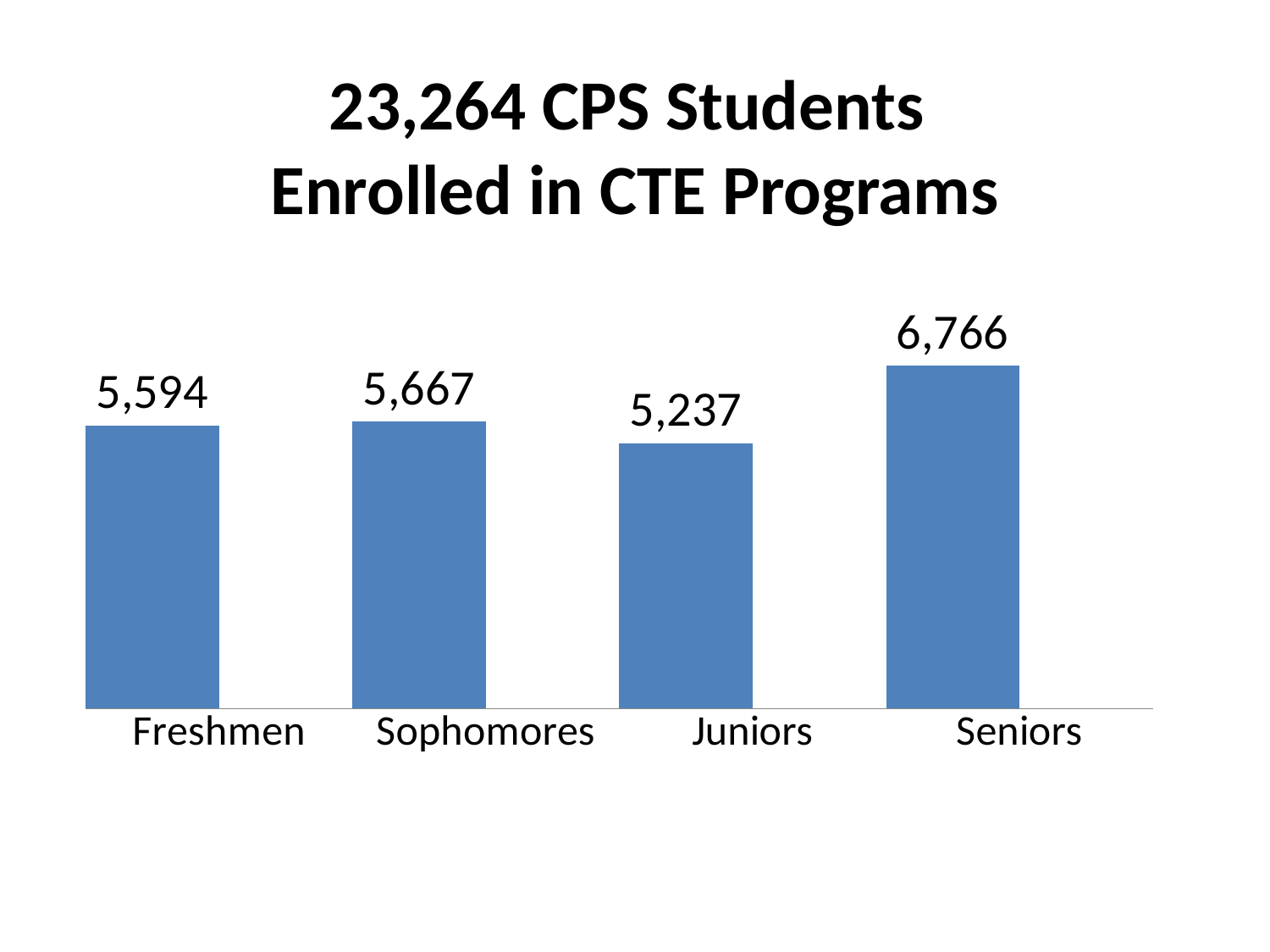
What kind of chart is shown on the slide? Bar chart Which category has the lowest number of students enrolled in CTE programs? Juniors What is the title of the chart? 23,264 CPS Students Enrolled in CTE Programs What is the value shown for Sophomores? 5,667 Which is larger, the value for Freshmen or the value for Juniors? Freshmen What is the value shown for Seniors? 6,766 How many CPS students in the Freshmen category are enrolled in CTE programs? 5,594 What is the difference between the Sophomores value and the Freshmen value? 73 Which category has the highest number of students enrolled in CTE programs? Seniors What is the difference between the Seniors value and the Juniors value? 1,529 How many categories are shown on the x axis? 4 What is the value shown for Juniors? 5,237